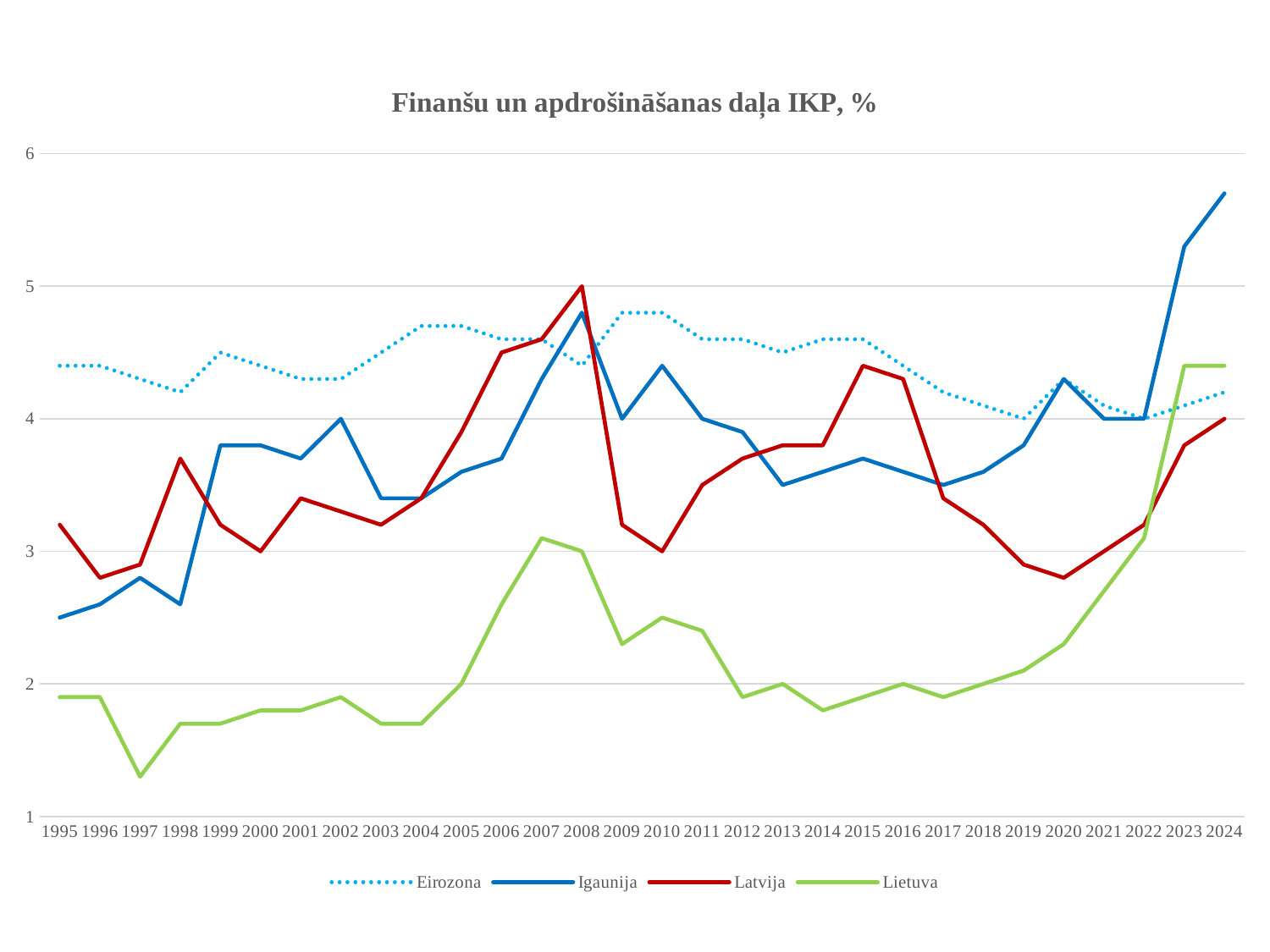
How many years are shown on the x axis? 30 In 2024, which is larger: the value for Lietuva or the value for Latvija? Lietuva Is the value for Igaunija in 2024 greater or less than 5? greater Is the value for Lietuva in 1997 greater or less than 2? less Which series is drawn with a dotted line? Eirozona What kind of chart is shown on the slide? line chart How many series does the legend list? 4 Is the value for Latvija in 2020 greater or less than 3? less Which series has the lowest value in 1995? Lietuva Does the Lietuva line rise or fall from 2020 to 2024? rise Which series has the highest value in 2024? Igaunija